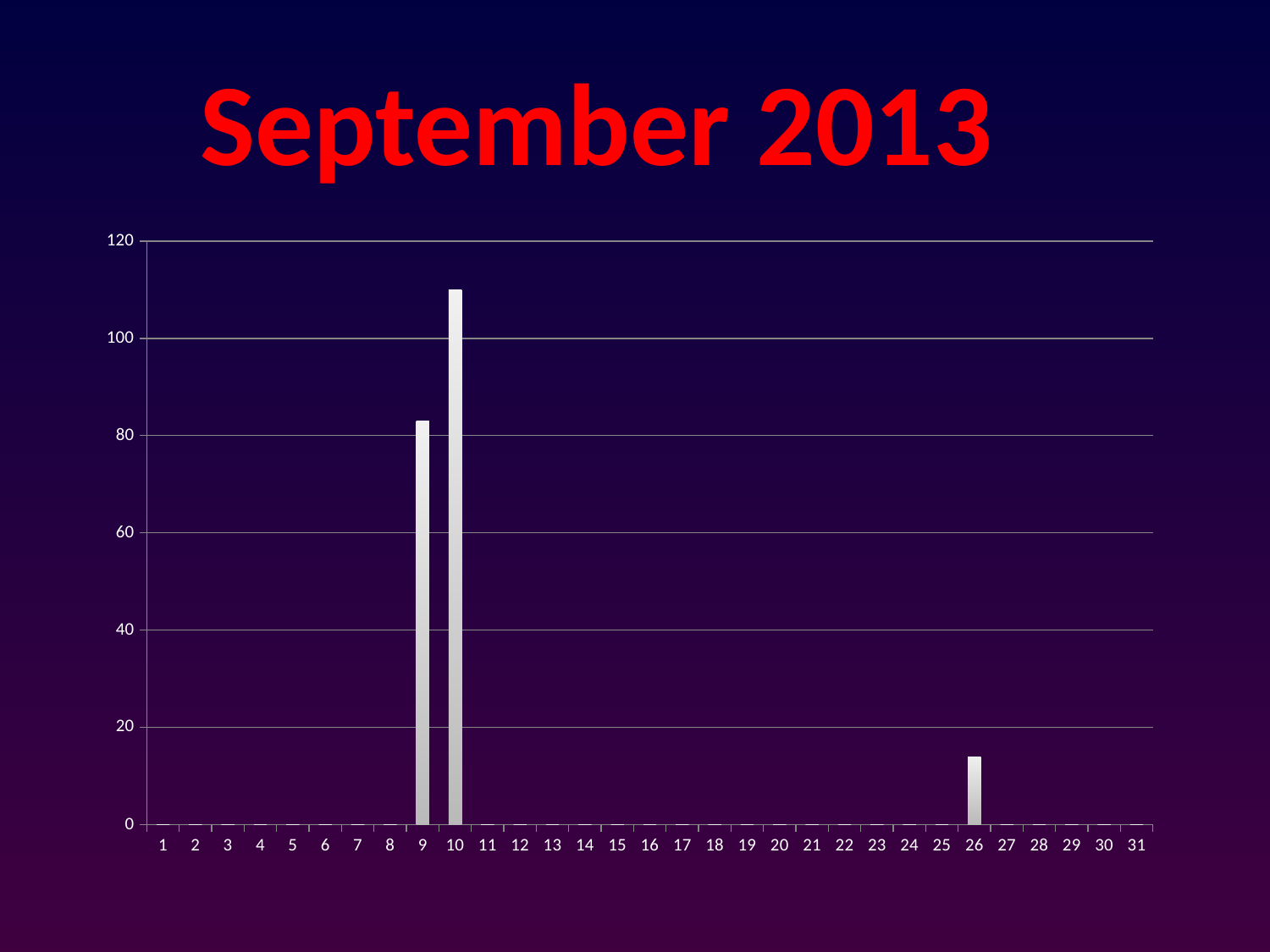
What kind of chart is shown on the slide? bar chart What is the highest value shown on the y axis? 120 Is the value for day 9 greater or less than 100? less Is the value for day 9 greater or less than 60? greater How many categories are shown along the x axis? 31 What is the title of the slide? September 2013 Which is larger, the value for day 9 or the value for day 10? day 10 How many days have a visible bar above zero? 3 Is the value for day 10 greater or less than 100? greater Which day has the highest bar? 10 Which is larger, the value for day 9 or the value for day 26? day 9